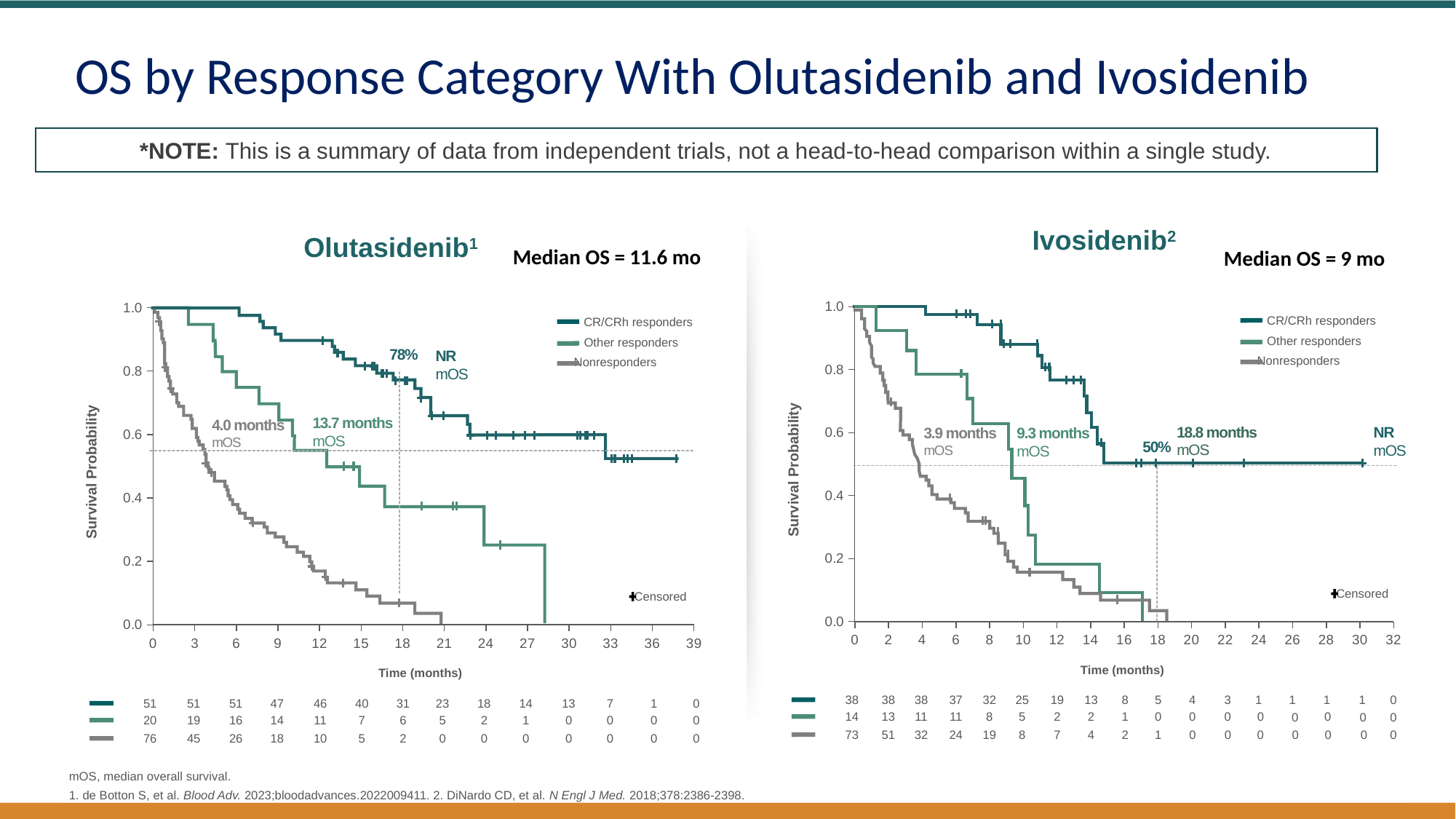
On the Ivosidenib chart, what is the mOS for nonresponders? 3.9 months On the Olutasidenib chart, what is the overall median OS shown? 11.6 mo On the Olutasidenib chart, how many nonresponders are at risk at time 0? 76 On the Olutasidenib chart, which group has the highest survival probability at 18 months? CR/CRh responders On the Ivosidenib chart, what survival probability is annotated at 18 months? 50% On the Olutasidenib chart, what is the mOS for nonresponders? 4.0 months On the Ivosidenib chart, what is the mOS for other responders? 9.3 months On the Ivosidenib chart, what is the overall median OS shown? 9 mo How many series does the legend of the Ivosidenib chart list? 3 What kind of chart is used on the Olutasidenib panel? line chart On the Olutasidenib chart, what survival probability is annotated for CR/CRh responders at 18 months? 78% On the Olutasidenib chart, what is the mOS for other responders? 13.7 months